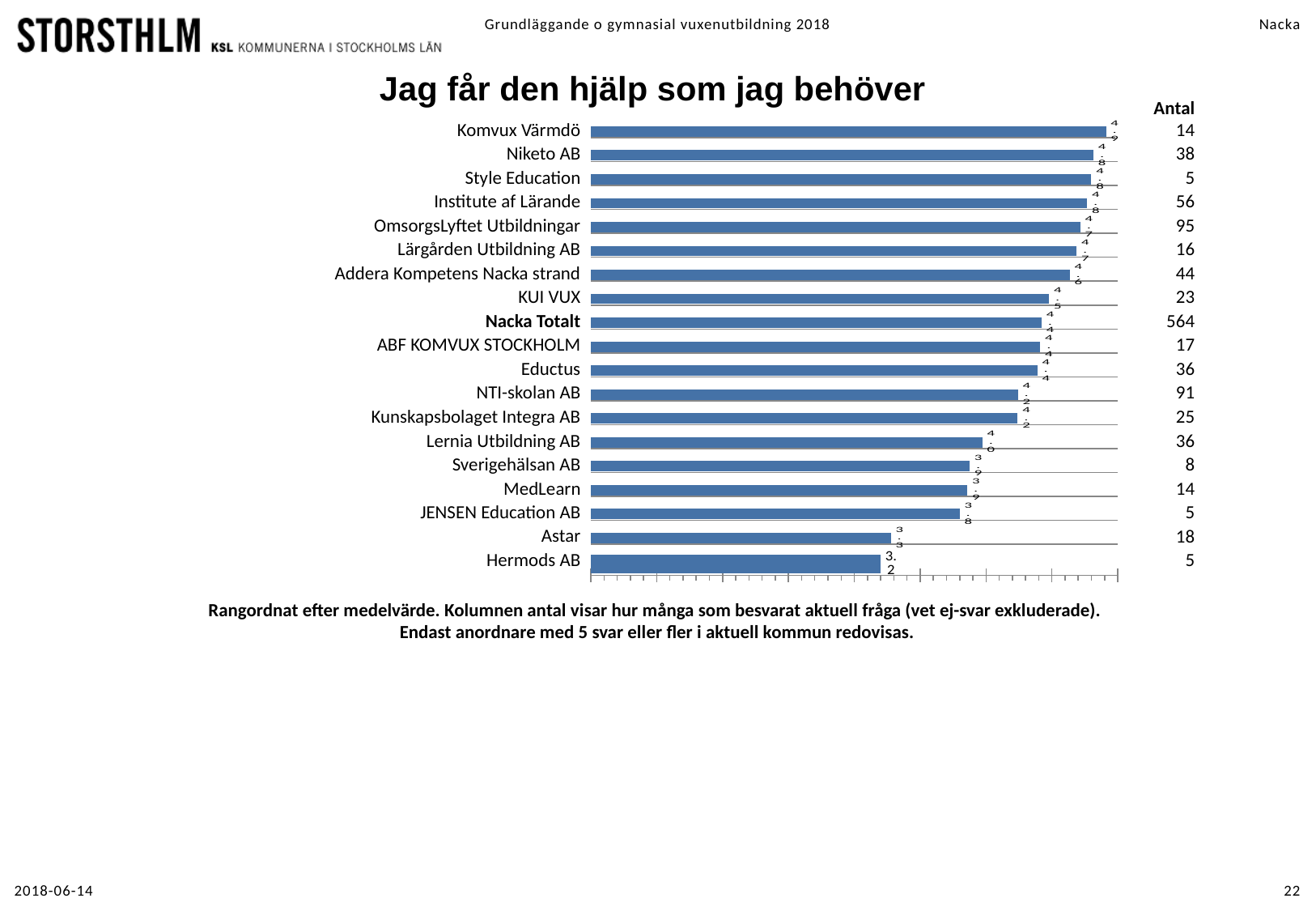
What kind of chart is shown on the slide? bar chart What is the value for Nacka Totalt? 4.4 What is the value for Hermods AB? 3.2 What is the value for Komvux Värmdö? 4.9 Which category has the highest value in the chart? Komvux Värmdö What is the title of the chart? Jag får den hjälp som jag behöver What is the difference between the values for Komvux Värmdö and Hermods AB? 1.7 Which category has the lowest value in the chart? Hermods AB How many categories (providers) are plotted in the chart? 19 Do the bar values rise or fall going from the top of the chart to the bottom? fall Which has a larger value, Lernia Utbildning AB or Astar? Lernia Utbildning AB What is the value for KUI VUX? 4.5